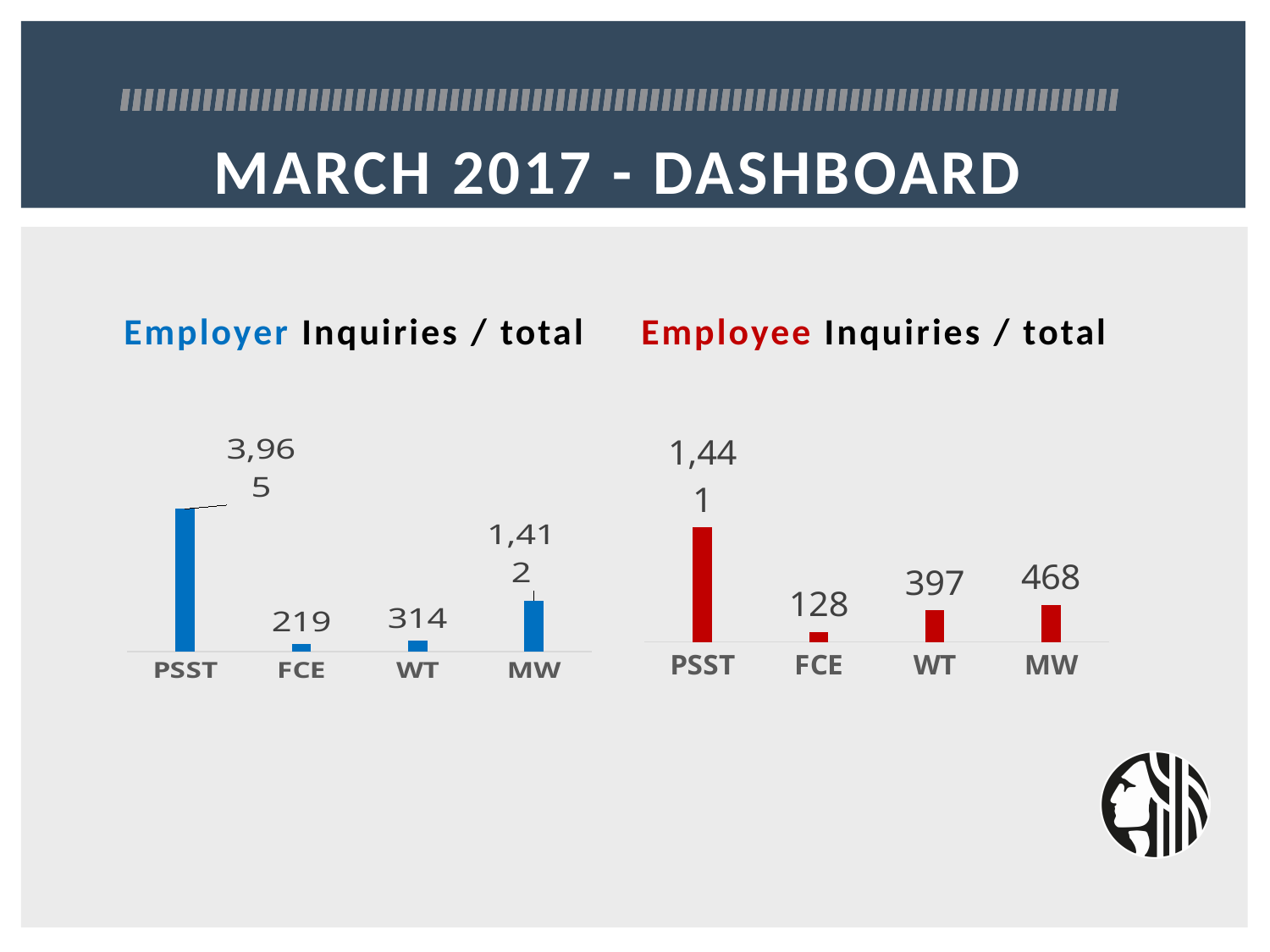
In the Employee Inquiries / total chart, which category has the lowest value? FCE In the Employer Inquiries / total chart, which category has the lowest value? FCE What type of chart is the Employer Inquiries / total chart? Bar chart In the Employer Inquiries / total chart, what is the value for MW? 1,412 In the Employer Inquiries / total chart, which category has the highest value? PSST In the Employer Inquiries / total chart, what is the difference between the values for WT and FCE? 95 How many categories are shown in the Employee Inquiries / total chart? 4 In the Employee Inquiries / total chart, what is the value for FCE? 128 Which is larger: the PSST value in the Employer Inquiries / total chart or the PSST value in the Employee Inquiries / total chart? Employer Inquiries / total In the Employer Inquiries / total chart, what is the value for PSST? 3,965 In the Employee Inquiries / total chart, what is the difference between the values for MW and WT? 71 In the Employee Inquiries / total chart, what is the value for WT? 397